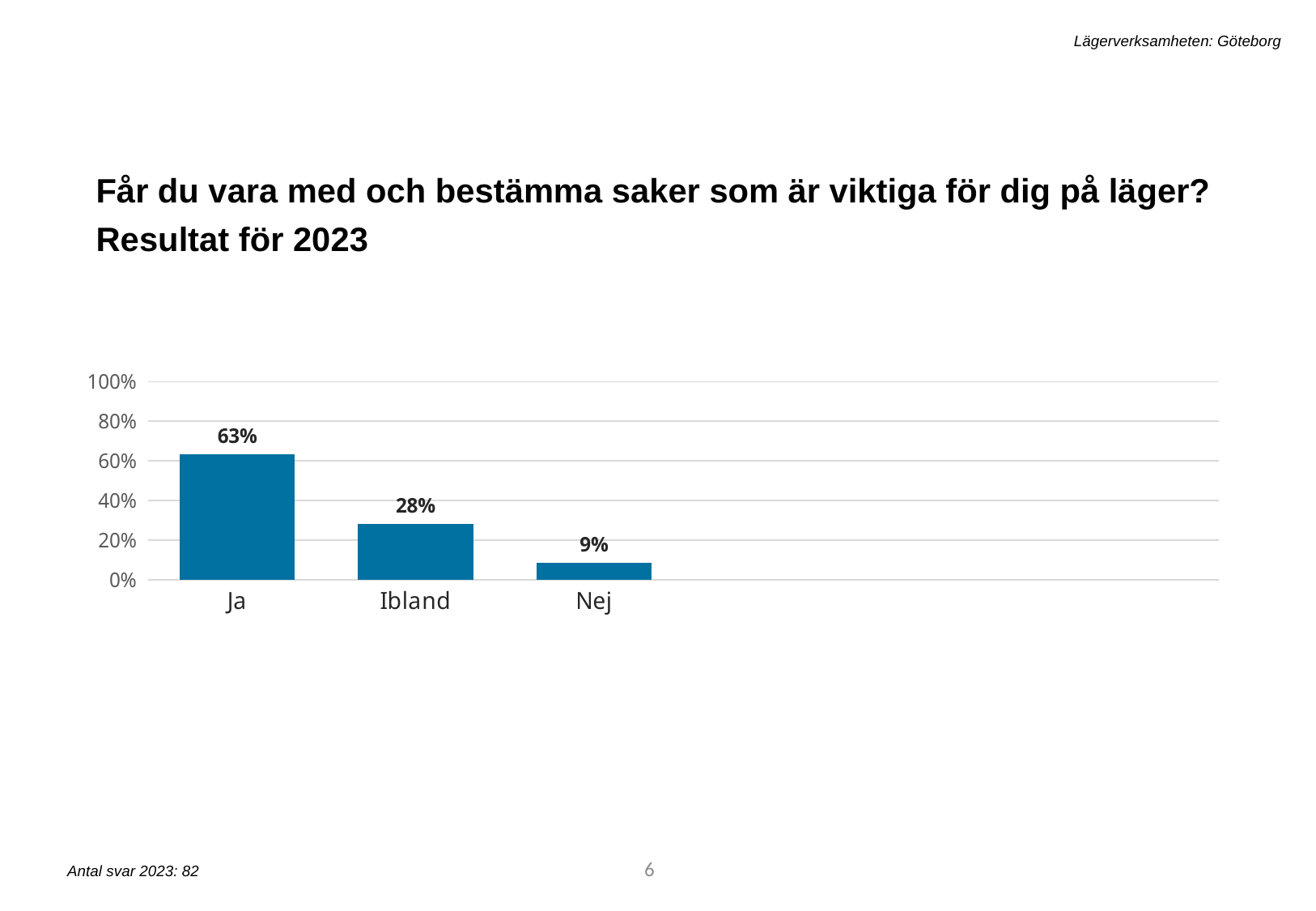
What kind of chart is shown on the slide? bar chart Which is larger, the value for Ibland or the value for Nej? Ibland What is the value for Ibland? 28% What is the difference between the values for Ja and Ibland? 35% What is the value for Ja? 63% Is the value for Ja greater or less than 40%? greater Which category has the highest value? Ja What is the difference between the values for Ibland and Nej? 19% Do the values rise or fall from left to right along the x axis? fall Which category has the lowest value? Nej What is the value for Nej? 9% How many categories are shown on the x axis? 3